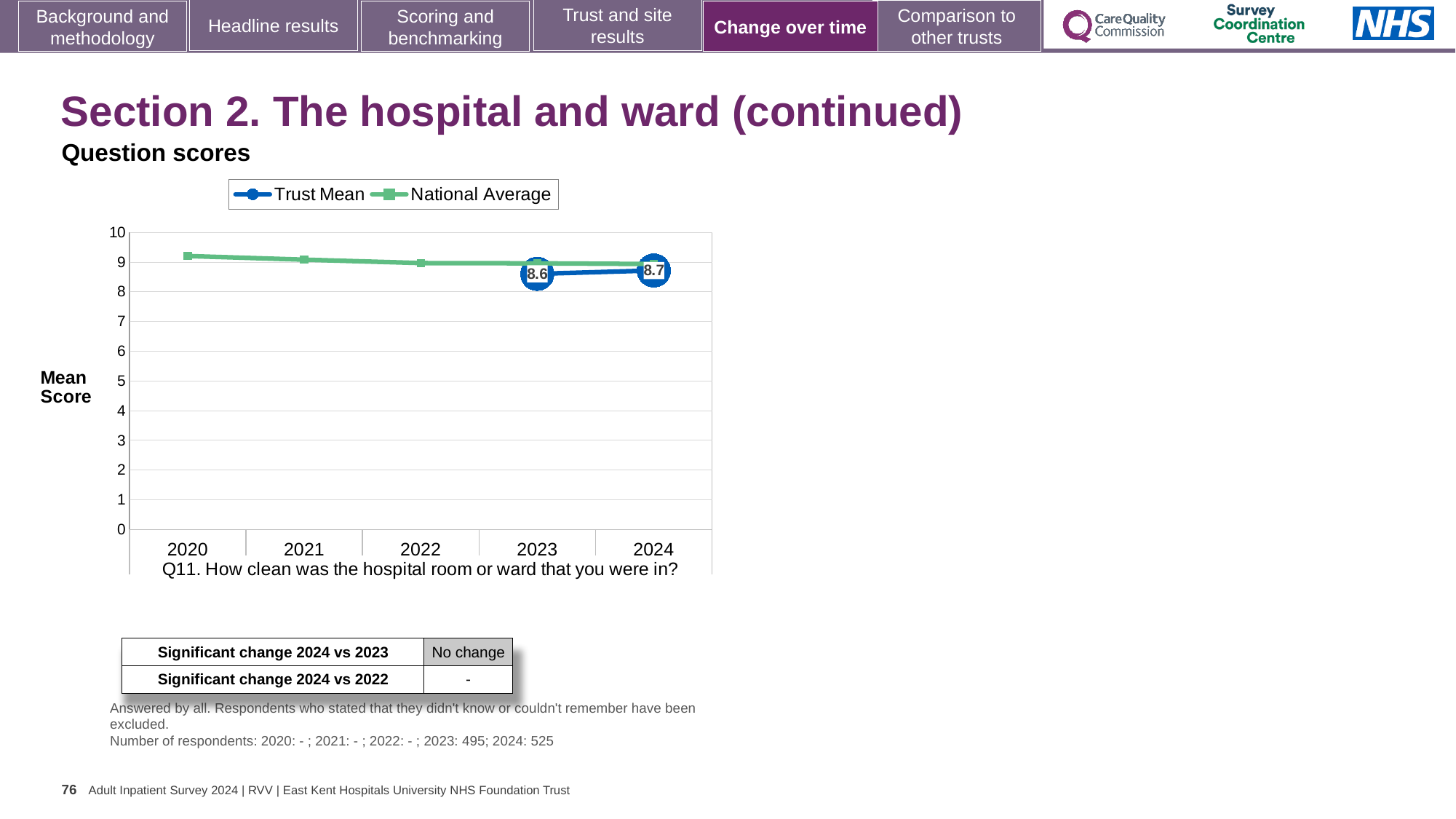
What is the Trust Mean value for 2024? 8.7 What is the Trust Mean value for 2023? 8.6 Which year has the higher Trust Mean, 2023 or 2024? 2024 What kind of chart is shown on the slide? Line chart Does the Trust Mean rise or fall from 2023 to 2024? rise Is the National Average value for 2020 greater or less than 8? greater What is the difference between the Trust Mean values for 2024 and 2023? 0.1 How many series does the legend list? 2 Which series is drawn in green in the chart? National Average For how many years is a Trust Mean value plotted? 2 What is the label on the y axis of the chart? Mean Score How many years are shown on the x axis? 5